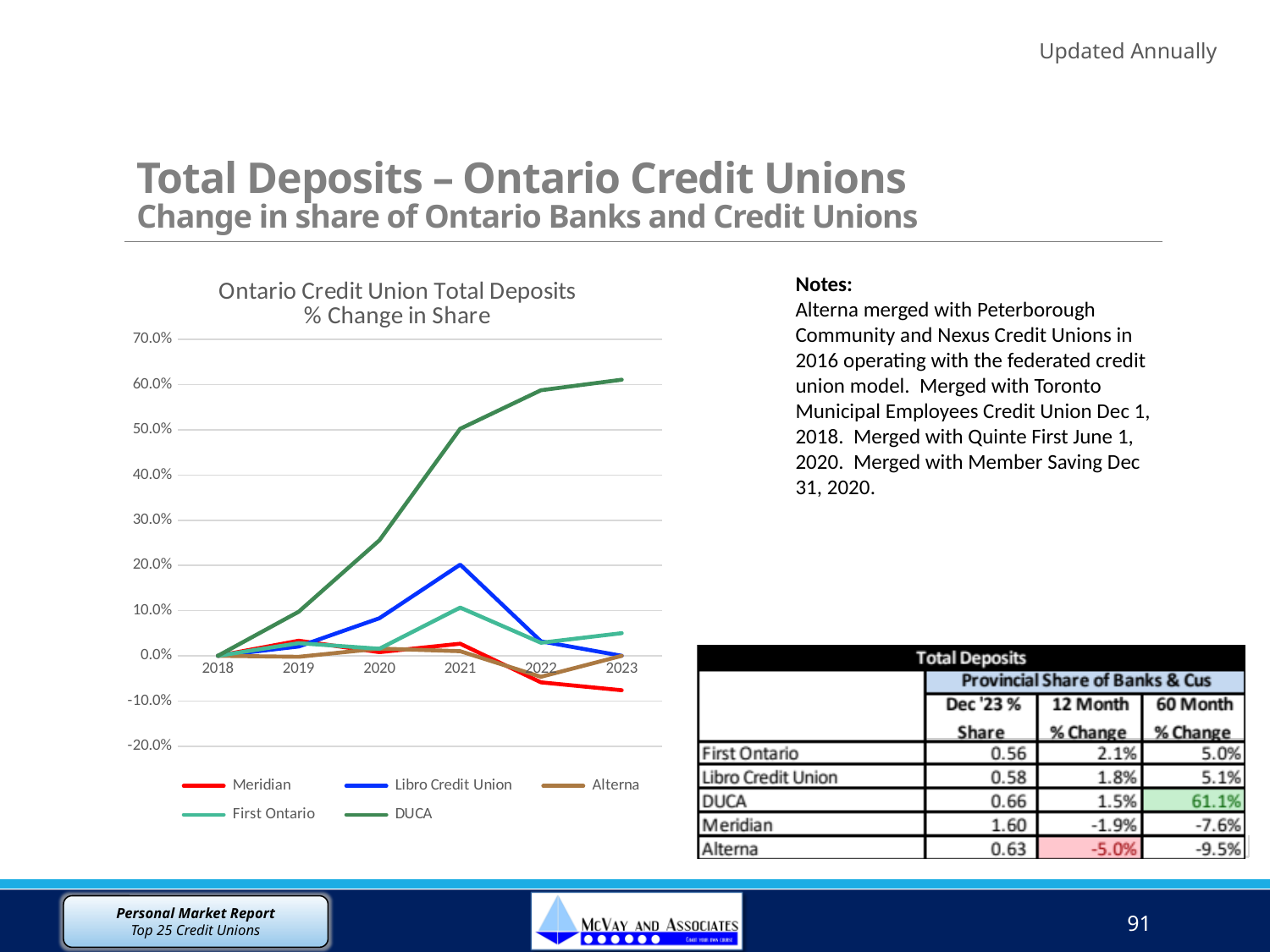
In 2021, which is larger: the value for DUCA or the value for Libro Credit Union? DUCA In 2021, which is larger: the value for Libro Credit Union or the value for First Ontario? Libro Credit Union Is the value for Meridian in 2023 greater or less than 0.0%? less Does the DUCA line rise or fall from 2018 to 2023? rise What kind of chart is shown on the slide? line chart Is the value for Libro Credit Union in 2021 greater or less than 10.0%? greater Which series has the highest value in 2023? DUCA How many years are shown along the x axis of the chart? 6 Is the value for DUCA in 2023 greater or less than 50.0%? greater Which series has the lowest value in 2023? Meridian What is the title of the chart? Ontario Credit Union Total Deposits % Change in Share How many series does the chart legend list? 5